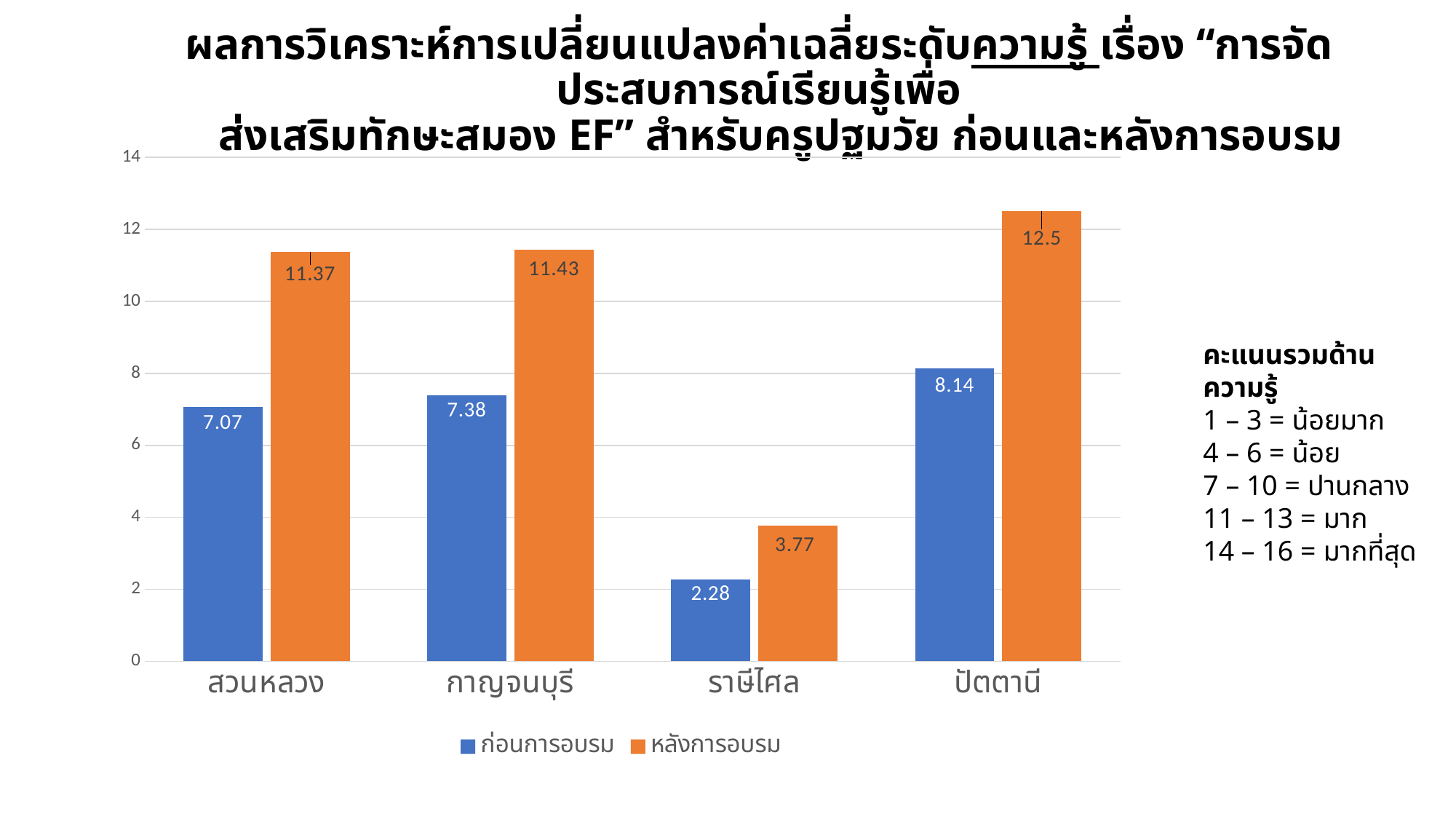
Which is larger: ก่อนการอบรม at ปัตตานี or ก่อนการอบรม at สวนหลวง? ปัตตานี What is the value for หลังการอบรม at ราษีไศล? 3.77 Which colour represents the series หลังการอบรม in the legend? orange How many categories are shown on the x axis? 4 How many series does the legend list? 2 What is the value for หลังการอบรม at ปัตตานี? 12.5 What kind of chart is shown on the slide? bar chart Which category has the lowest value for ก่อนการอบรม? ราษีไศล Is the value for หลังการอบรม at สวนหลวง greater or less than 10? greater Which category has the highest value for หลังการอบรม? ปัตตานี What is the difference between หลังการอบรม and ก่อนการอบรม at กาญจนบุรี? 4.05 What is the value for ก่อนการอบรม at สวนหลวง? 7.07